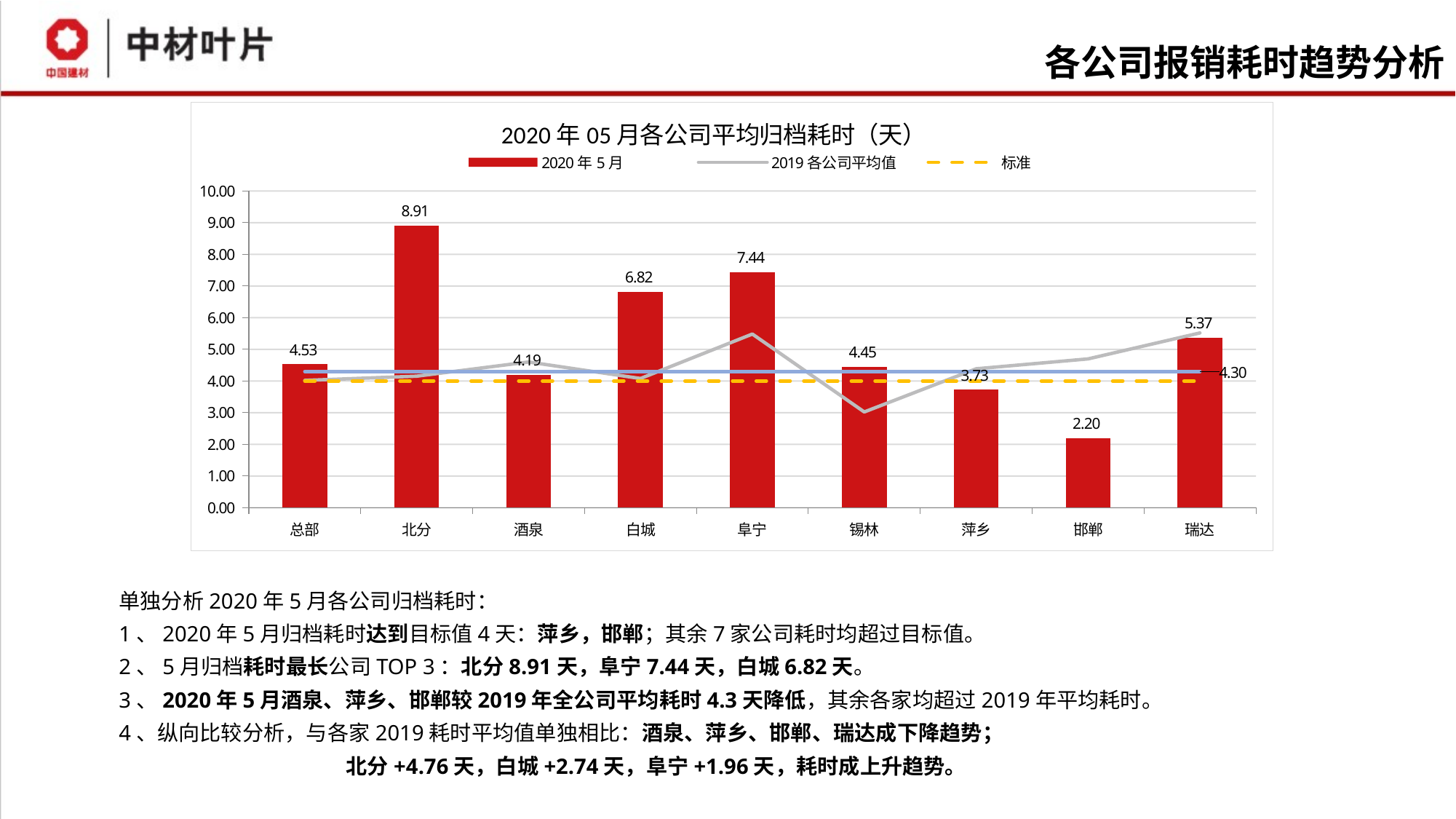
Which has a larger 2020年5月 value, 白城 or 阜宁? 阜宁 What is the 2020年5月 value for 北分? 8.91 Which company has the lowest 2020年5月 bar? 邯郸 What is the 2020年5月 value for 瑞达? 5.37 Is the 2019各公司平均值 value for 锡林 greater or less than 4.00? less What is the difference between the 2020年5月 values for 北分 and 邯郸? 6.71 How many series does the legend list? 3 What is the 2020年5月 value for 邯郸? 2.20 What is the difference between the 2020年5月 values for 阜宁 and 白城? 0.62 Which company has the highest 2020年5月 bar? 北分 What kind of chart is used for the 2020年5月 series? bar chart How many companies are shown on the x axis? 9